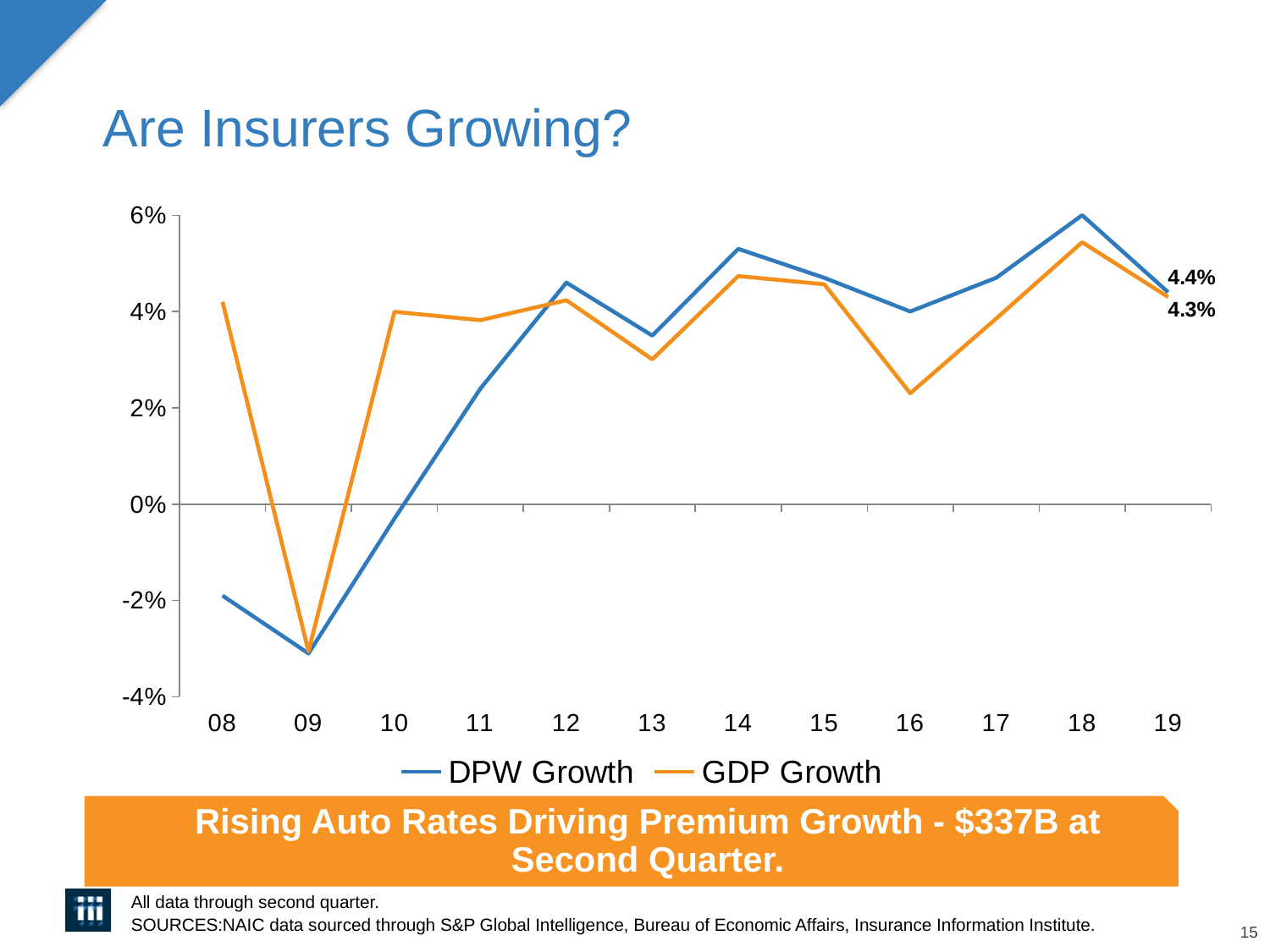
What is the difference between DPW Growth and GDP Growth in 19? 0.1% How many series does the legend list? 2 How many years are plotted along the x axis? 12 Is the GDP Growth value for 16 greater or less than 4%? less What kind of chart is shown on the slide? line chart In which year is GDP Growth lowest? 09 In 19, which is larger, DPW Growth or GDP Growth? DPW Growth What is the GDP Growth value for 19? 4.3% Does DPW Growth rise or fall from 09 to 12? rise In which year is DPW Growth highest? 18 What is the DPW Growth value for 19? 4.4% Is the DPW Growth value for 09 greater or less than -2%? less